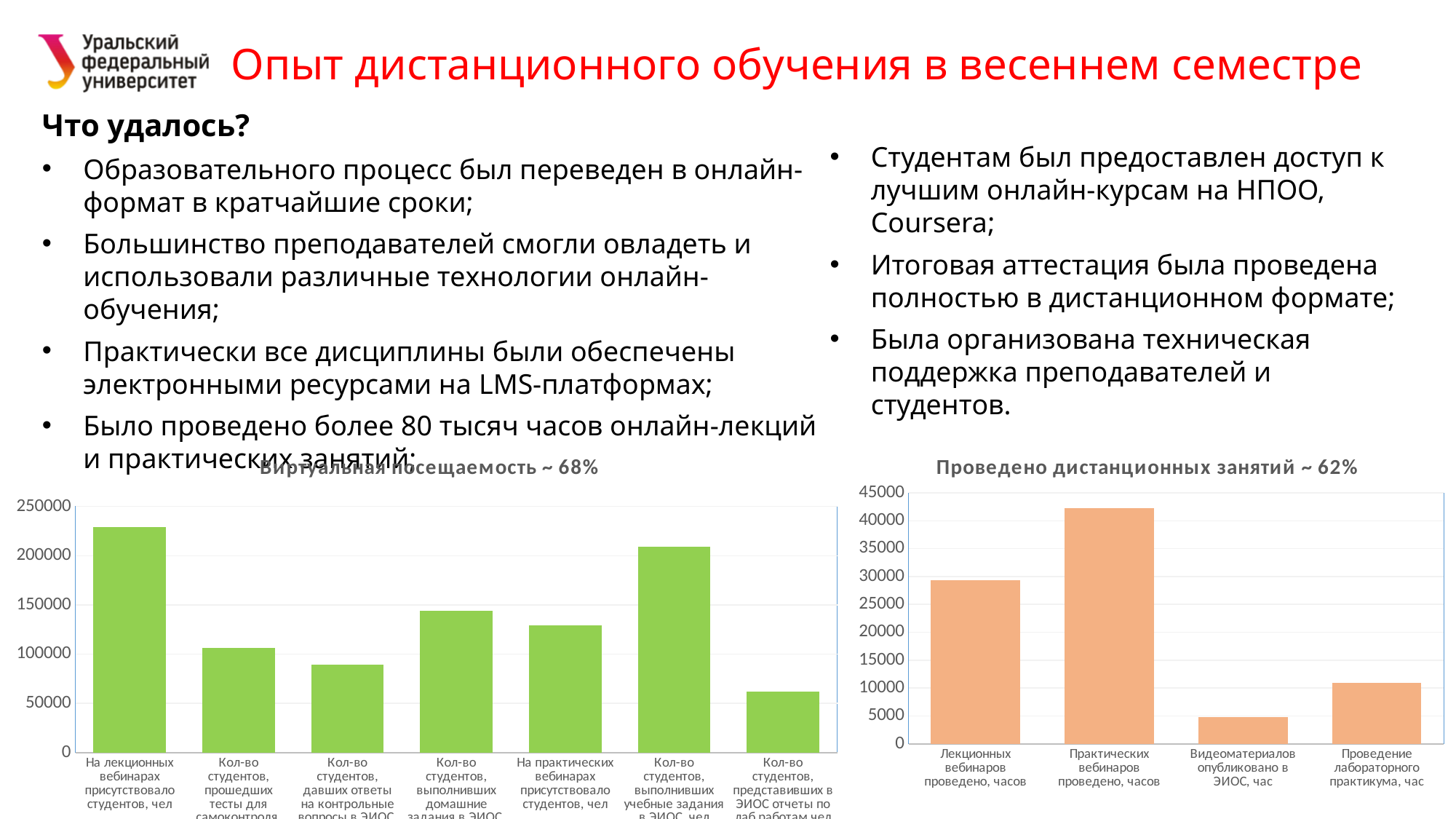
In the chart titled "Виртуальная посещаемость ~ 68%", which category has the lowest value? Кол-во студентов, представивших в ЭИОС отчеты по лаб работам, чел In the chart titled "Проведено дистанционных занятий ~ 62%", is the value for "Лекционных вебинаров проведено, часов" greater or less than 25000? greater In the chart titled "Виртуальная посещаемость ~ 68%", which is larger: the value for "Кол-во студентов, выполнивших домашние задания в ЭИОС" or the value for "Кол-во студентов, прошедших тесты для самоконтроля"? Кол-во студентов, выполнивших домашние задания в ЭИОС In the chart titled "Виртуальная посещаемость ~ 68%", is the value for "На практических вебинарах присутствовало студентов, чел" greater or less than 150000? less What kind of chart is the chart titled "Виртуальная посещаемость ~ 68%"? bar chart In the chart titled "Виртуальная посещаемость ~ 68%", is the value for "На лекционных вебинарах присутствовало студентов, чел" greater or less than 200000? greater How many bars does the chart titled "Виртуальная посещаемость ~ 68%" have? 7 What colour are the bars in the chart titled "Проведено дистанционных занятий ~ 62%"? orange In the chart titled "Проведено дистанционных занятий ~ 62%", which category has the lowest value? Видеоматериалов опубликовано в ЭИОС, час In the chart titled "Проведено дистанционных занятий ~ 62%", which category has the highest value? Практических вебинаров проведено, часов In the chart titled "Виртуальная посещаемость ~ 68%", which category has the highest value? На лекционных вебинарах присутствовало студентов, чел How many bars does the chart titled "Проведено дистанционных занятий ~ 62%" have? 4